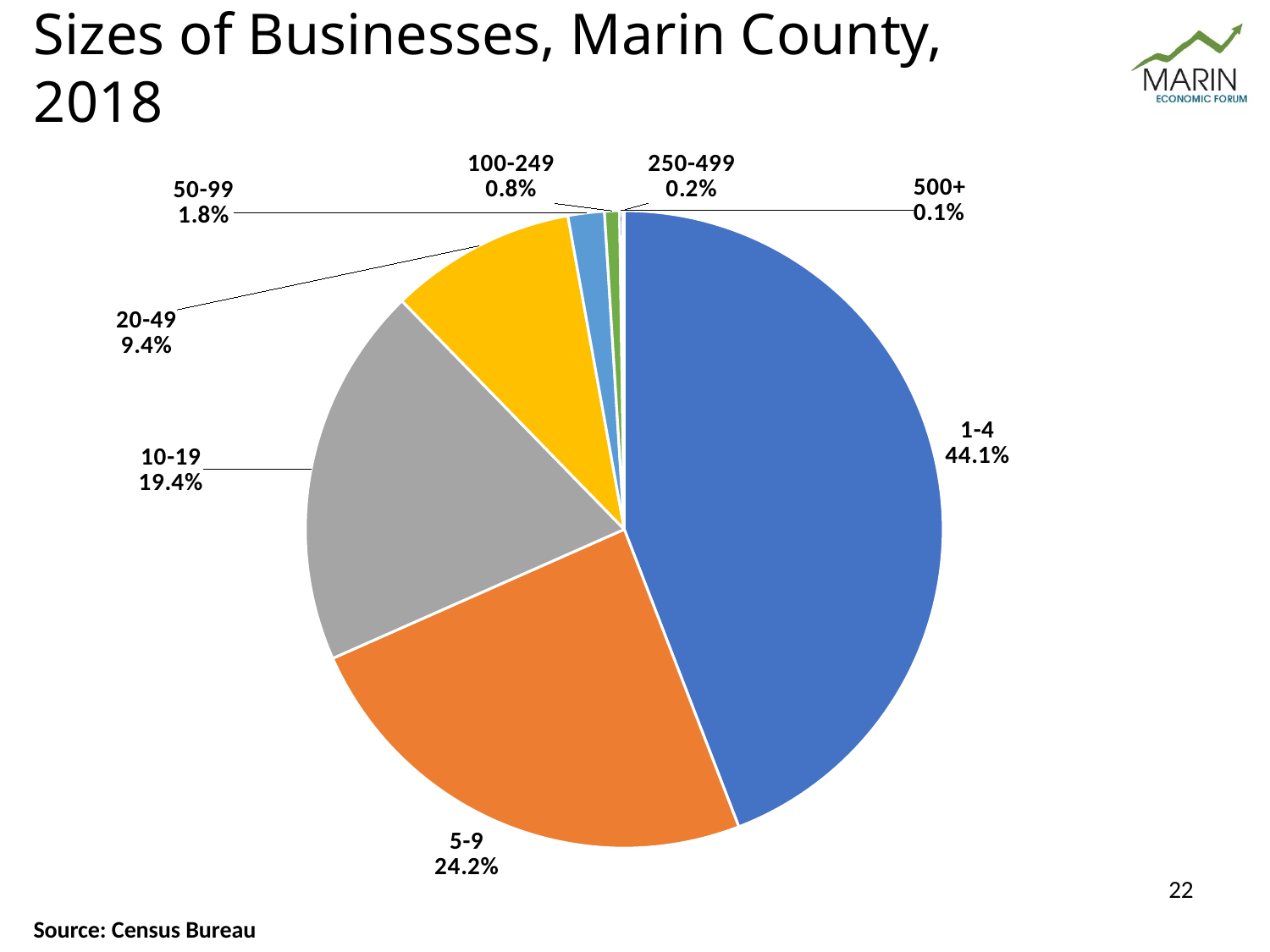
What is the title of the chart? Sizes of Businesses, Marin County, 2018 What is the difference in percentage points between the 5-9 and 10-19 categories? 4.8 What is the source cited for the chart data? Census Bureau What share of businesses have 1-4 employees? 44.1% What is the combined share of the 1-4 and 5-9 categories? 68.3% What share of businesses have 50-99 employees? 1.8% Which business size category has the smallest share? 500+ What share of businesses have 10-19 employees? 19.4% What kind of chart is shown on the slide? Pie chart How many business size categories are shown in the pie chart? 8 Which has a larger share, 20-49 or 50-99? 20-49 Which business size category has the largest share? 1-4